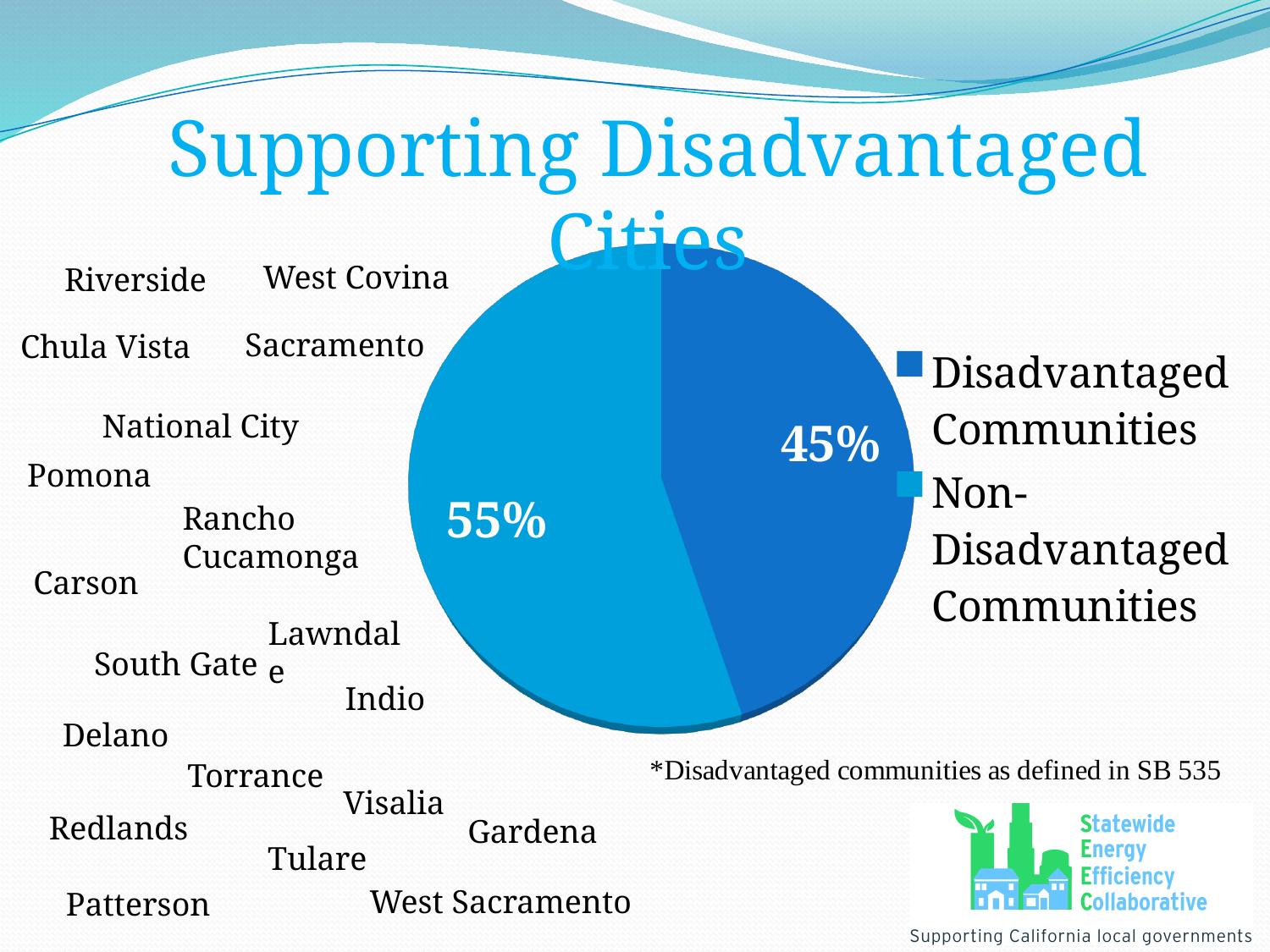
What kind of chart is shown on the slide? pie chart Which slice of the pie is the largest? Non-Disadvantaged Communities What share of the pie does the Disadvantaged Communities slice represent? 45% Which is larger, the Disadvantaged Communities slice or the Non-Disadvantaged Communities slice? Non-Disadvantaged Communities Which slice of the pie is the smallest? Disadvantaged Communities What percentage of the pie is Non-Disadvantaged Communities? 55% How many slices does the pie chart have? 2 What percentage of the pie is Disadvantaged Communities? 45% How many entries does the legend list? 2 Which legend entry is shown in the darker blue colour? Disadvantaged Communities What is the title of the slide containing the pie chart? Supporting Disadvantaged Cities What is the difference in percentage points between the Non-Disadvantaged Communities slice and the Disadvantaged Communities slice? 10